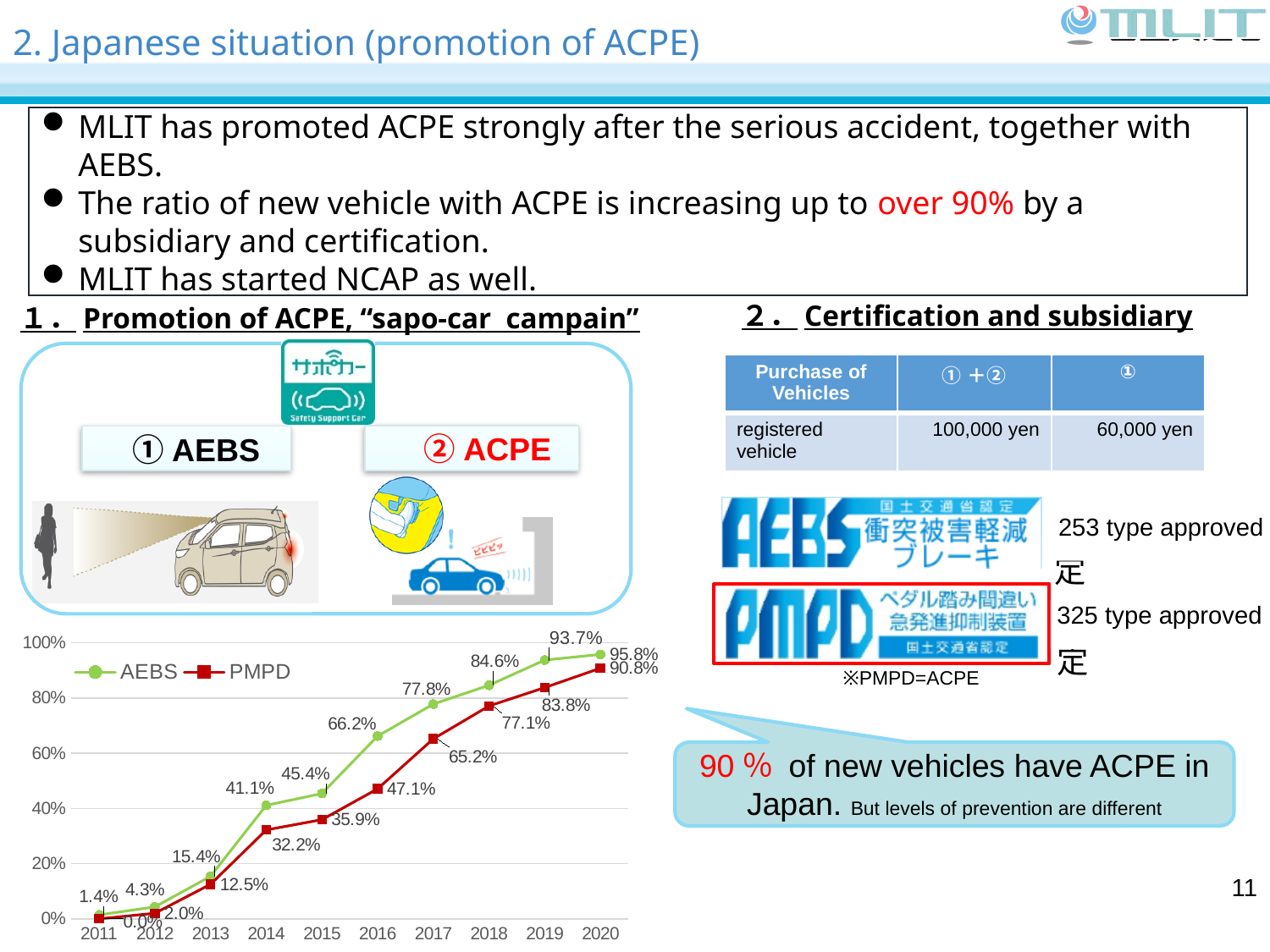
What is the difference between the AEBS and PMPD values in 2016? 19.1% What is the AEBS value for 2020? 95.8% How many series does the chart legend list? 2 How many years are plotted on the x axis of the chart? 10 What type of chart is shown on the slide? line chart Do the AEBS values rise or fall from 2011 to 2020? rise In which year is the AEBS value lowest? 2011 What is the AEBS value for 2014? 41.1% In which year is the PMPD value highest? 2020 Which series has the larger value in 2019, AEBS or PMPD? AEBS What is the PMPD value for 2017? 65.2% What is the PMPD value for 2011? 0.0%